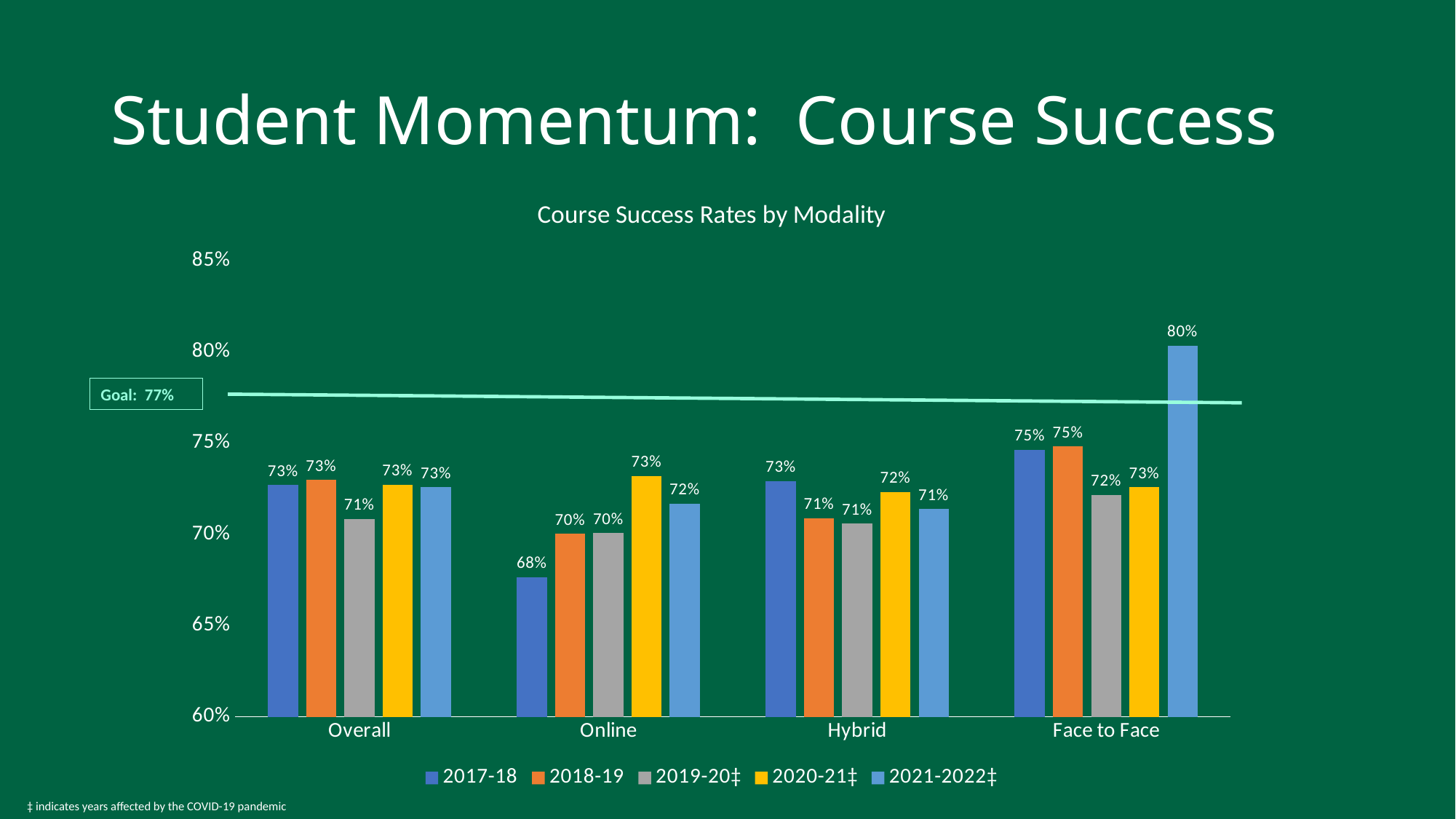
What is the course success rate for Online in 2017-18? 68% How many modality categories are shown on the x axis? 4 What is the course success rate for Hybrid in 2020-21? 72% What is the course success rate for Face to Face in 2021-2022? 80% Is the Face to Face course success rate in 2021-2022 greater or less than 77%? greater Which is larger, the Hybrid rate in 2017-18 or the Hybrid rate in 2018-19? Hybrid rate in 2017-18 What goal value is marked by the horizontal line on the chart? 77% Which modality has the highest course success rate in 2021-2022? Face to Face What is the difference between the Face to Face and Online course success rates in 2021-2022? 8% How many series does the legend list? 5 What kind of chart is shown on the slide? bar chart Which modality has the lowest course success rate in 2017-18? Online